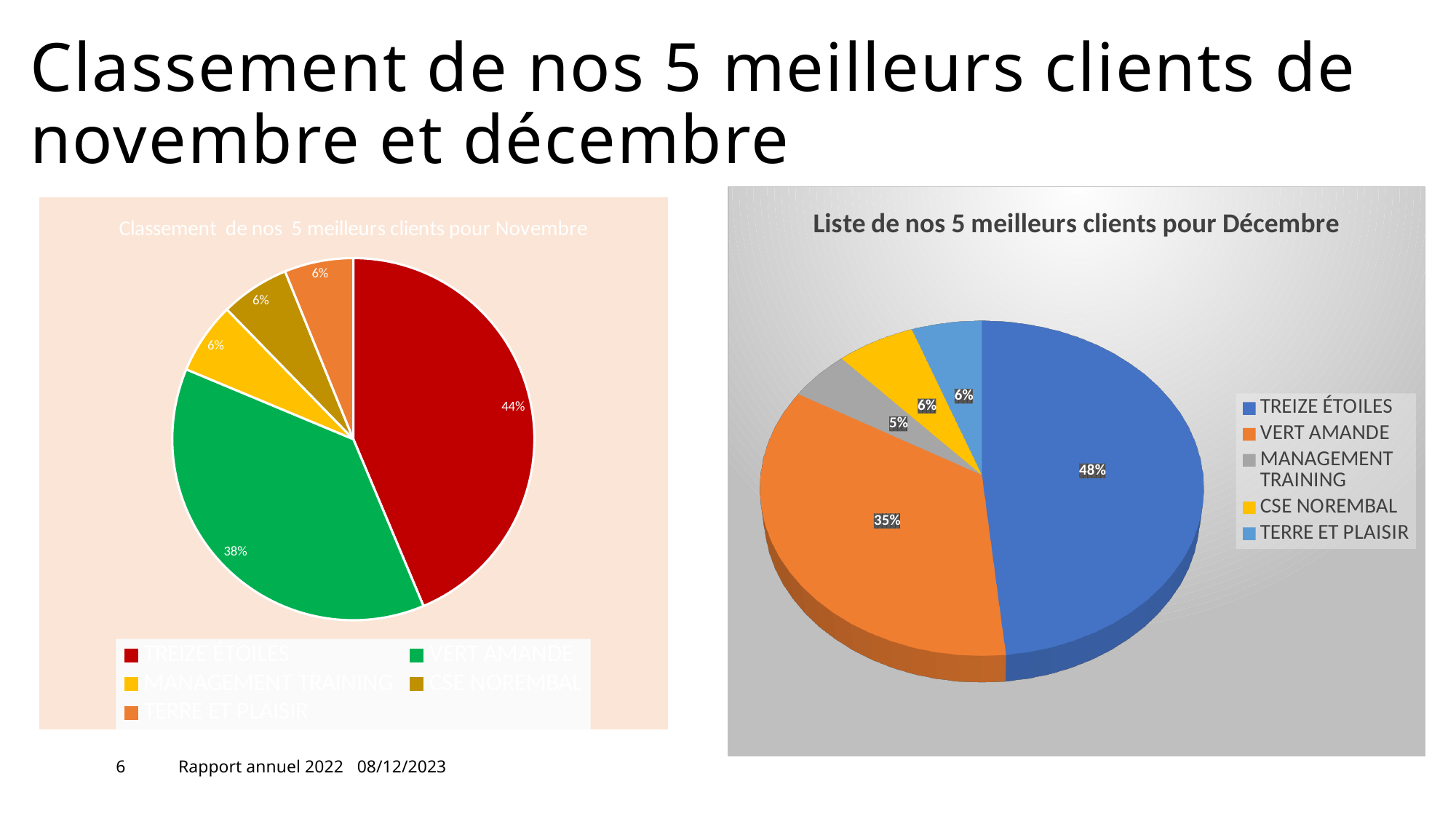
In the chart 'Liste de nos 5 meilleurs clients pour Décembre', what is the difference in percentage points between TREIZE ÉTOILES and VERT AMANDE? 13 In the chart 'Liste de nos 5 meilleurs clients pour Décembre', what share does MANAGEMENT TRAINING have? 5% In the chart 'Liste de nos 5 meilleurs clients pour Décembre', what colour is the slice for VERT AMANDE? Orange In the chart 'Liste de nos 5 meilleurs clients pour Décembre', what share does TREIZE ÉTOILES have? 48% In the chart 'Liste de nos 5 meilleurs clients pour Décembre', how many clients are listed in the legend? 5 In the chart 'Classement de nos 5 meilleurs clients pour Novembre', what share does TREIZE ÉTOILES have? 44% What type of chart is 'Liste de nos 5 meilleurs clients pour Décembre'? Pie chart In the chart 'Liste de nos 5 meilleurs clients pour Décembre', which client has the smallest share? MANAGEMENT TRAINING In the chart 'Classement de nos 5 meilleurs clients pour Novembre', what share does VERT AMANDE have? 38% In the chart 'Liste de nos 5 meilleurs clients pour Décembre', what share does VERT AMANDE have? 35% In the chart 'Liste de nos 5 meilleurs clients pour Décembre', which client has the largest share? TREIZE ÉTOILES In the chart 'Classement de nos 5 meilleurs clients pour Novembre', which is larger, the share of TREIZE ÉTOILES or VERT AMANDE? TREIZE ÉTOILES